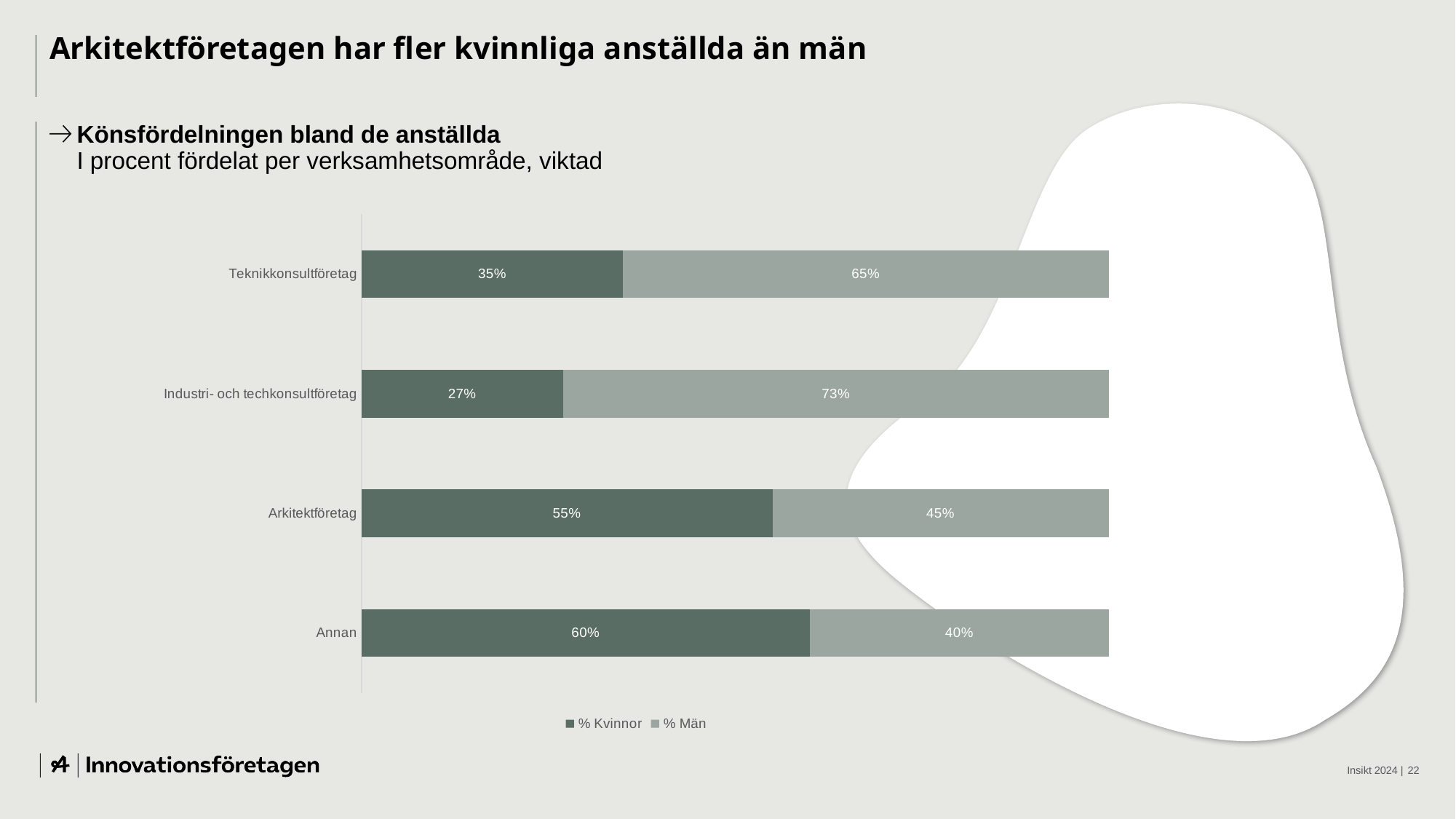
How many series does the legend list? 2 What is the total of the stacked bar for Industri- och techkonsultföretag? 100% Which category has the lowest % Kvinnor value? Industri- och techkonsultföretag What is the difference between the % Män and % Kvinnor values for Teknikkonsultföretag? 30% What is the % Kvinnor value for Teknikkonsultföretag? 35% What is the % Män value for Annan? 40% How many categories are shown in the chart? 4 What kind of chart is shown on the slide? Stacked bar chart What is the % Kvinnor value for Arkitektföretag? 55% Which category has the highest % Kvinnor value? Annan Which is larger for Arkitektföretag: % Kvinnor or % Män? % Kvinnor What is the % Män value for Industri- och techkonsultföretag? 73%